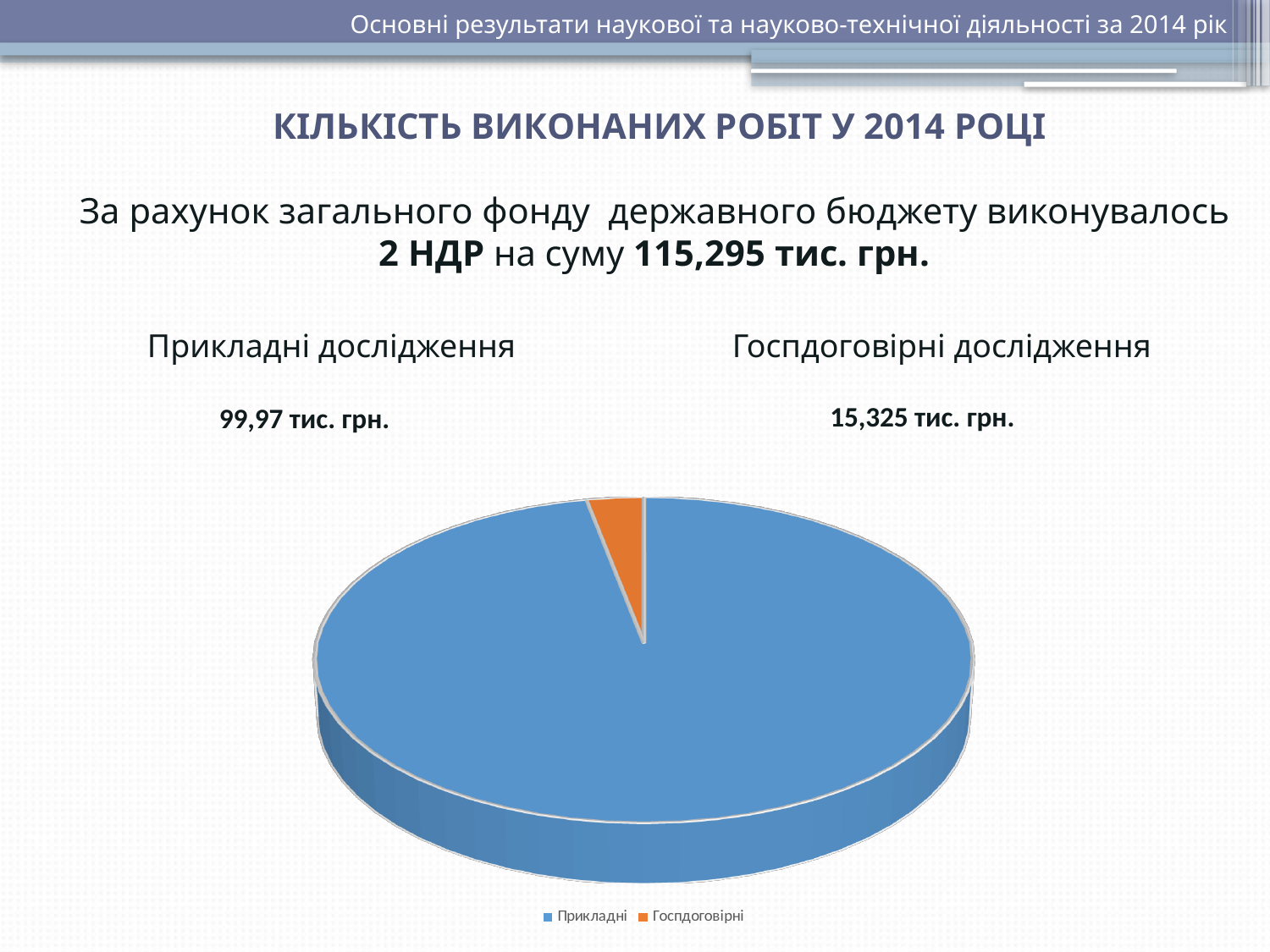
How many slices does the pie chart have? 2 Which category has the smallest slice in the pie chart? Госпдоговірні What amount is shown on the slide for Прикладні дослідження? 99,97 тис. грн. What kind of chart is shown on the slide? pie chart What amount is shown on the slide for Госпдоговірні дослідження? 15,325 тис. грн. How many entries does the legend of the pie chart list? 2 Which category has the largest slice in the pie chart? Прикладні What colour is the Прикладні slice in the pie chart? blue What colour is the Госпдоговірні slice in the pie chart? orange Which slice is larger, Прикладні or Госпдоговірні? Прикладні What total sum is stated on the slide for the 2 НДР? 115,295 тис. грн.